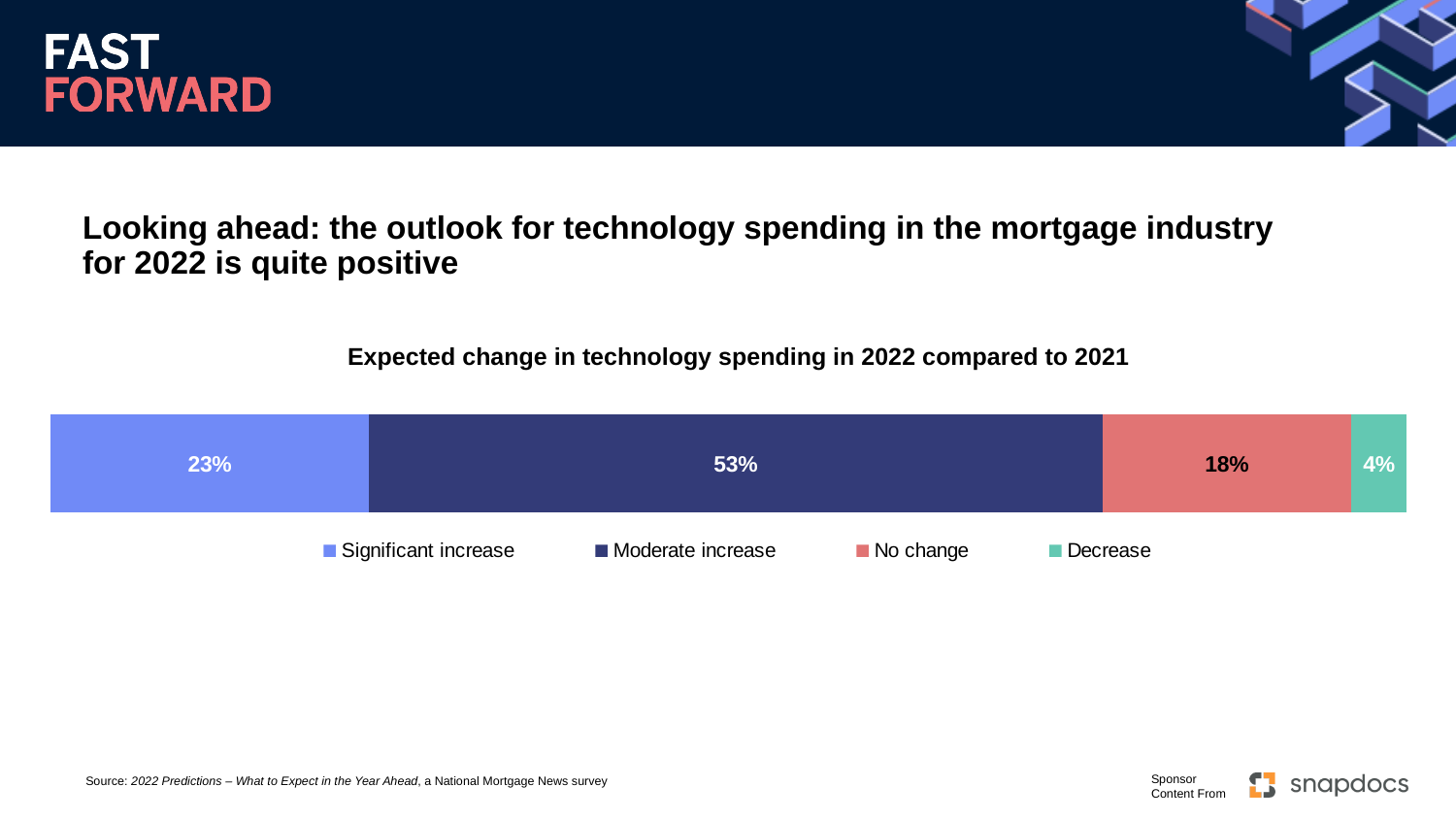
Which response category has the smallest share? Decrease Which response category has the largest share? Moderate increase How many categories does the legend list? 4 Which is larger, the share for 'No change' or the share for 'Decrease'? No change What percentage of respondents expect a significant increase in technology spending in 2022? 23% What is the combined percentage of respondents expecting either a significant or moderate increase? 76% What percentage of respondents expect no change in technology spending? 18% What is the title of the chart? Expected change in technology spending in 2022 compared to 2021 What is the difference in percentage points between 'Moderate increase' and 'Significant increase'? 30 What percentage of respondents expect a moderate increase in technology spending? 53% What percentage of respondents expect a decrease in technology spending? 4% What kind of chart is shown on the slide? Stacked bar chart